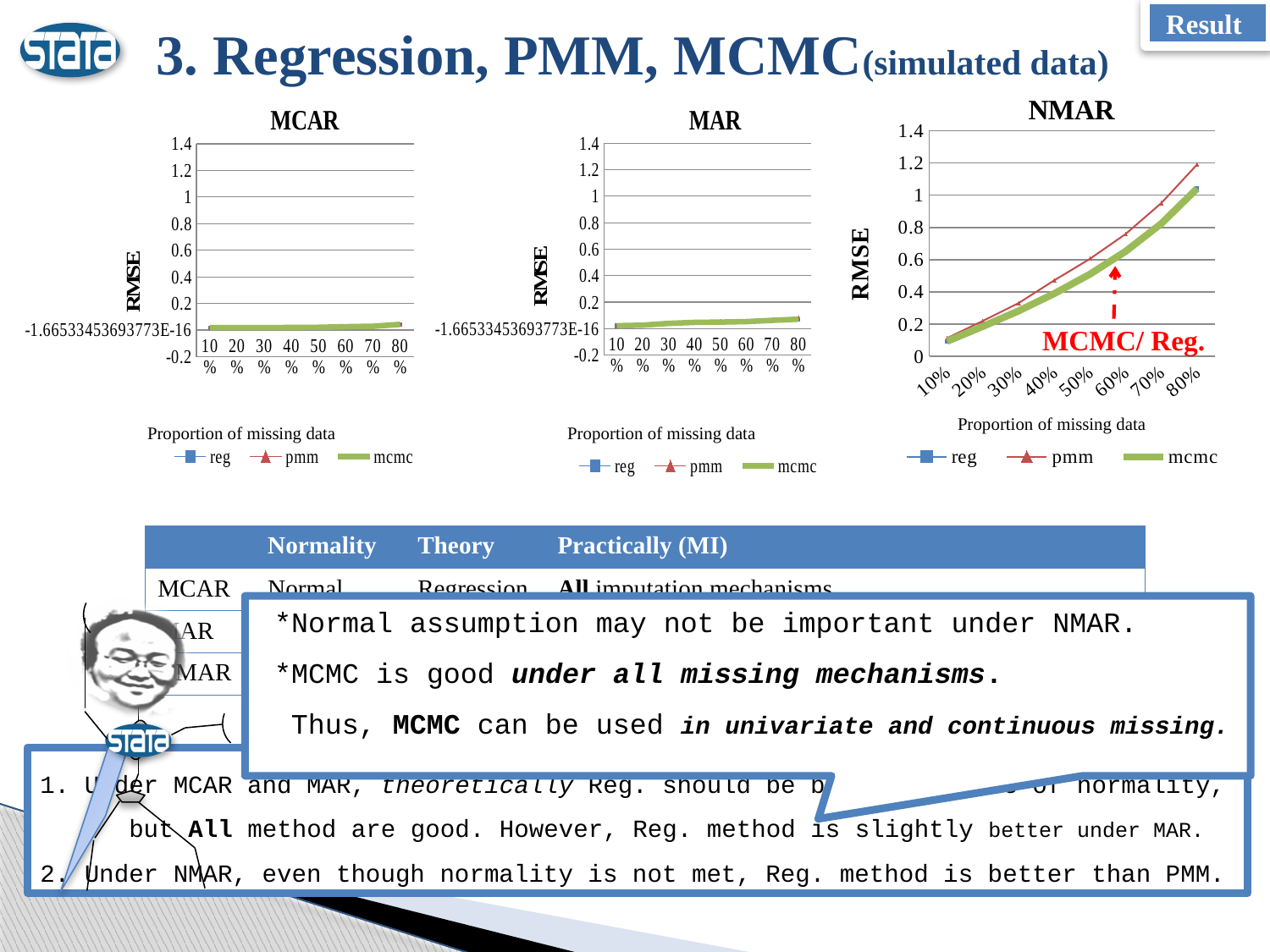
In the NMAR chart, do the RMSE values rise or fall as the proportion of missing data increases from 10% to 80%? rise In the MAR chart, is the mcmc value at 80% greater or less than 0.4? less In the MCAR chart, is the mcmc value at 80% greater or less than 0.2? less What is the y-axis title of the MAR chart? RMSE In the NMAR chart, how many proportion-of-missing-data points are shown on the x axis? 8 In the NMAR chart, how many series does the legend list? 3 In the MCAR chart, what are the three series named in the legend? reg, pmm, mcmc In the NMAR chart, at 80% missing data, which is larger: the pmm value or the mcmc value? pmm In the NMAR chart, which series has the highest RMSE at 80%? pmm In the NMAR chart, is the pmm value at 80% greater or less than 1? greater What kind of chart is the NMAR chart? line chart